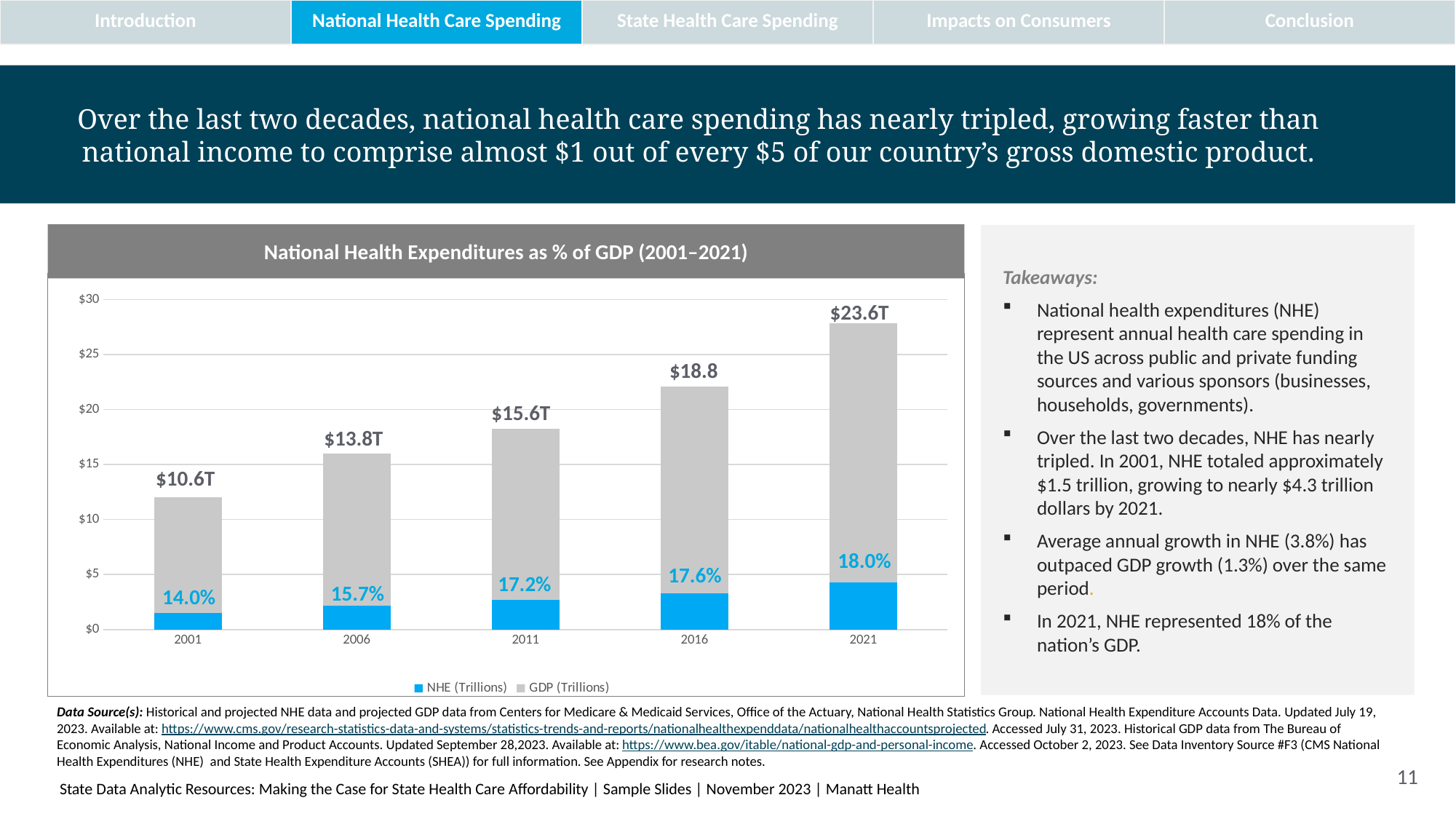
Is the top of the 2021 bar greater or less than $25? greater What is the title of the chart? National Health Expenditures as % of GDP (2001–2021) What value label is printed above the bar for 2006? $13.8T How many years are shown on the x axis of the chart? 5 What percentage label is shown on the NHE segment for 2021? 18.0% What is the difference between the NHE percentage labels for 2021 and 2001? 4.0 percentage points Which year has the lowest value label above its bar? 2001 Which year has the highest percentage label on its NHE segment? 2021 What kind of chart is shown on the slide? Stacked bar chart How many series does the chart legend list? 2 What percentage label is shown on the NHE segment for 2011? 17.2% Do the bar heights rise or fall from 2001 to 2021? Rise